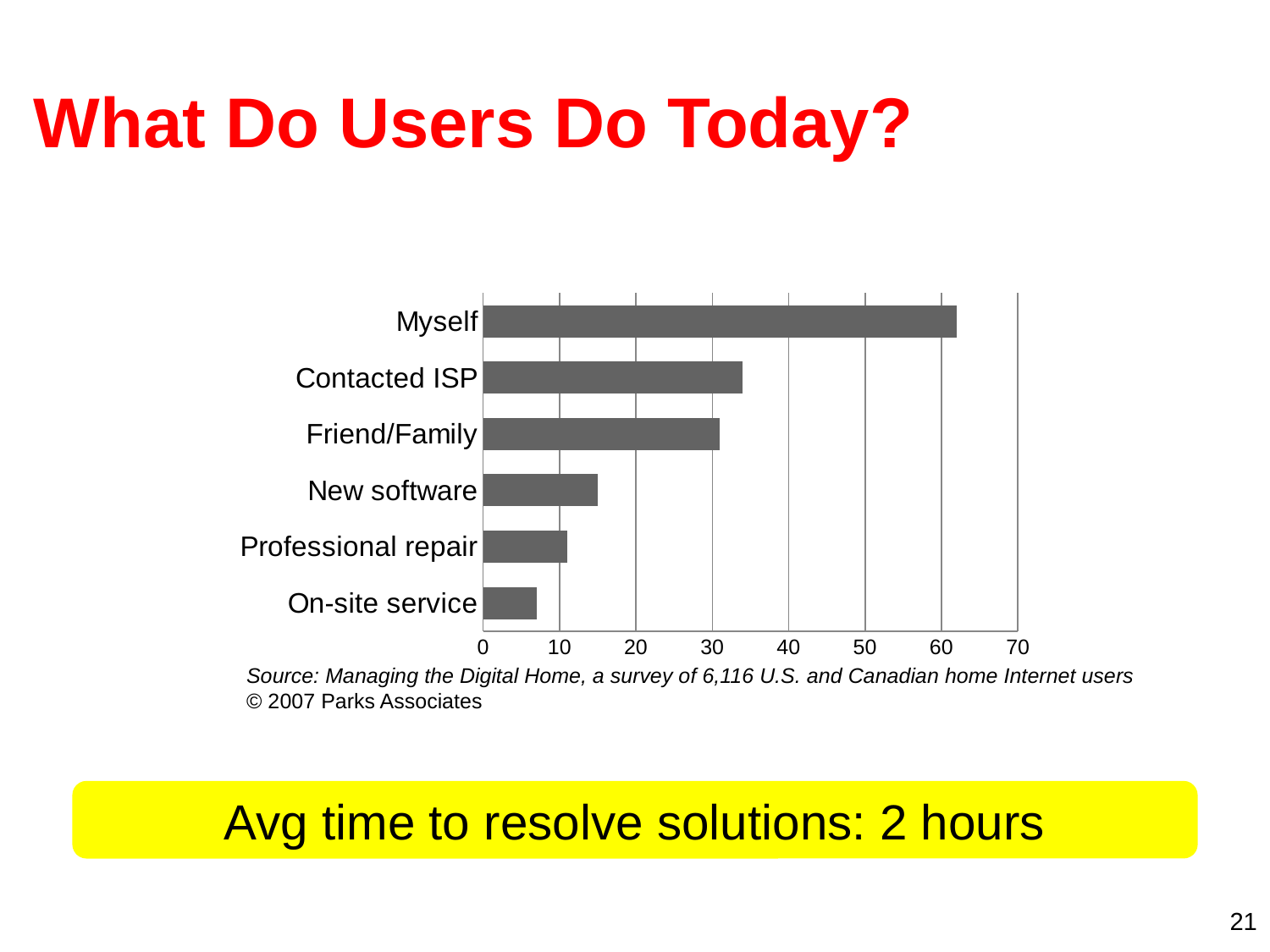
Is the value for Myself greater or less than 60? greater How many categories are shown in the chart? 6 Is the value for Contacted ISP greater or less than 30? greater Is the value for On-site service greater or less than 10? less Which is larger, the value for New software or the value for Professional repair? New software What is the maximum value shown on the horizontal axis? 70 Which category has the lowest value? On-site service Which category has the highest value? Myself What kind of chart is shown on the slide? bar chart Which is larger, the value for Myself or the value for Contacted ISP? Myself